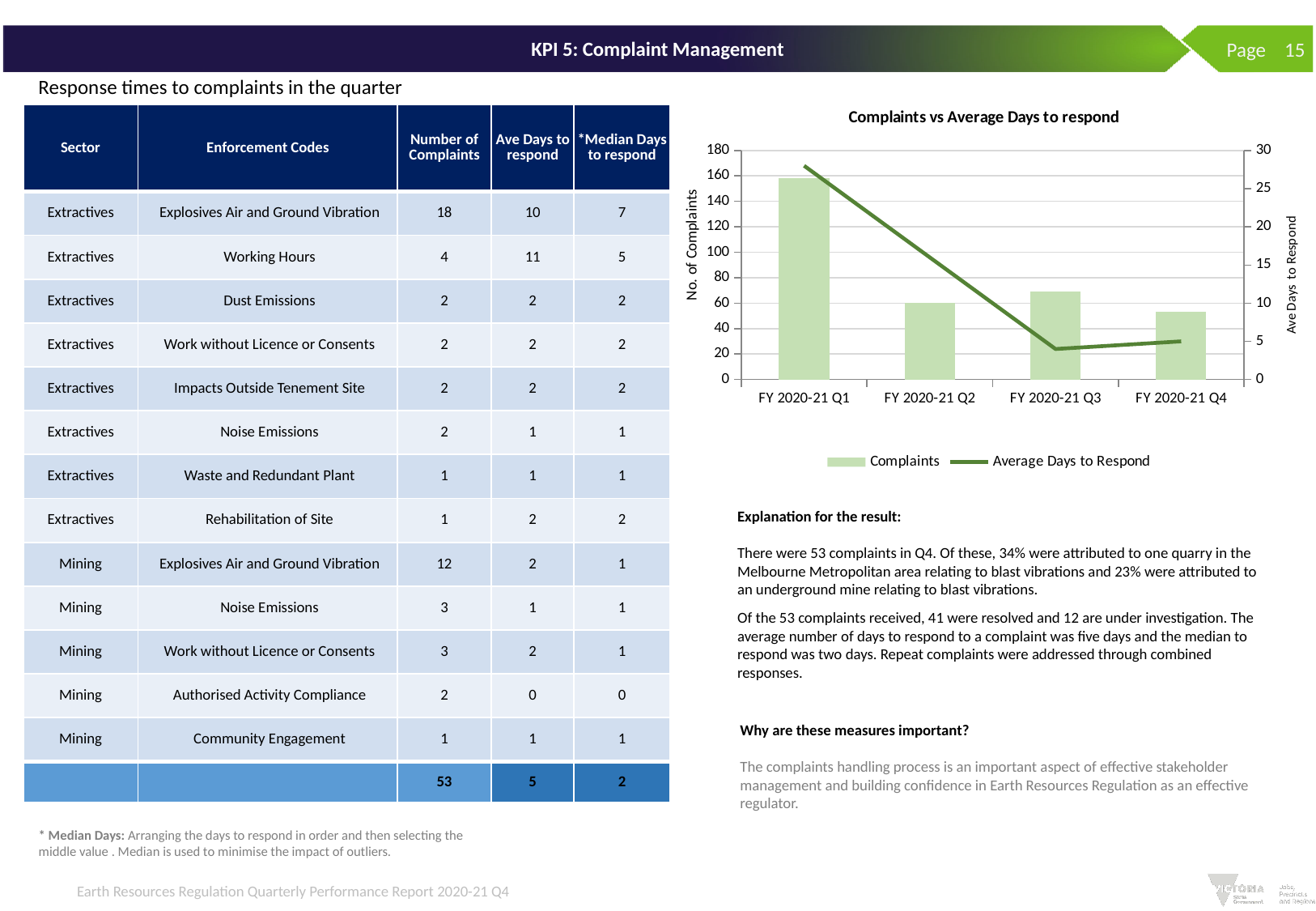
How many series does the chart legend list? 2 What is the title of the chart on the slide? Complaints vs Average Days to respond Is the average days to respond for FY 2020-21 Q1 greater or less than 25? greater Does the Average Days to Respond line rise or fall from FY 2020-21 Q1 to FY 2020-21 Q3? fall Is the number of complaints for FY 2020-21 Q4 greater or less than 60? less How many quarters are plotted on the x axis of the chart? 4 Which has more complaints, FY 2020-21 Q1 or FY 2020-21 Q2? FY 2020-21 Q1 What kind of chart is shown on the slide? A combination bar and line chart Is the number of complaints for FY 2020-21 Q1 greater or less than 140? greater Which quarter has the highest number of complaints in the chart? FY 2020-21 Q1 What is the label of the right-hand vertical axis of the chart? Ave Days to Respond